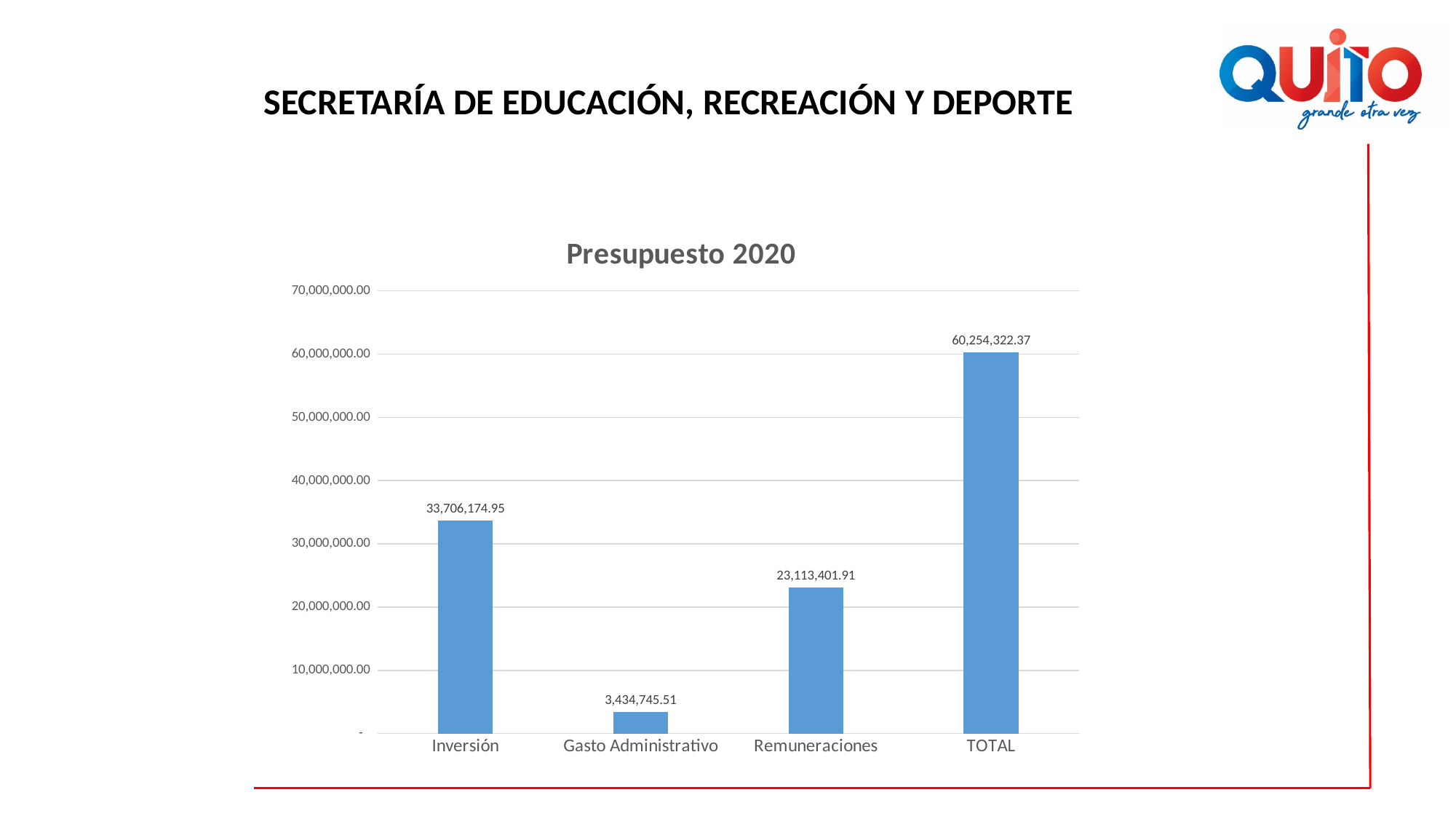
What is the difference between Inversión and Gasto Administrativo? 30,271,429.44 What is the value shown for TOTAL? 60,254,322.37 What is the title of the chart? Presupuesto 2020 Excluding the TOTAL bar, which category has the highest value? Inversión Which is larger, Remuneraciones or Gasto Administrativo? Remuneraciones What is the difference between Inversión and Remuneraciones? 10,592,773.04 How many bars are shown in the chart? 4 Which category has the lowest value? Gasto Administrativo What is the value for Remuneraciones? 23,113,401.91 Is the value for Remuneraciones greater or less than 20,000,000.00? greater What is the value for Gasto Administrativo? 3,434,745.51 What is the value for Inversión in the Presupuesto 2020 chart? 33,706,174.95